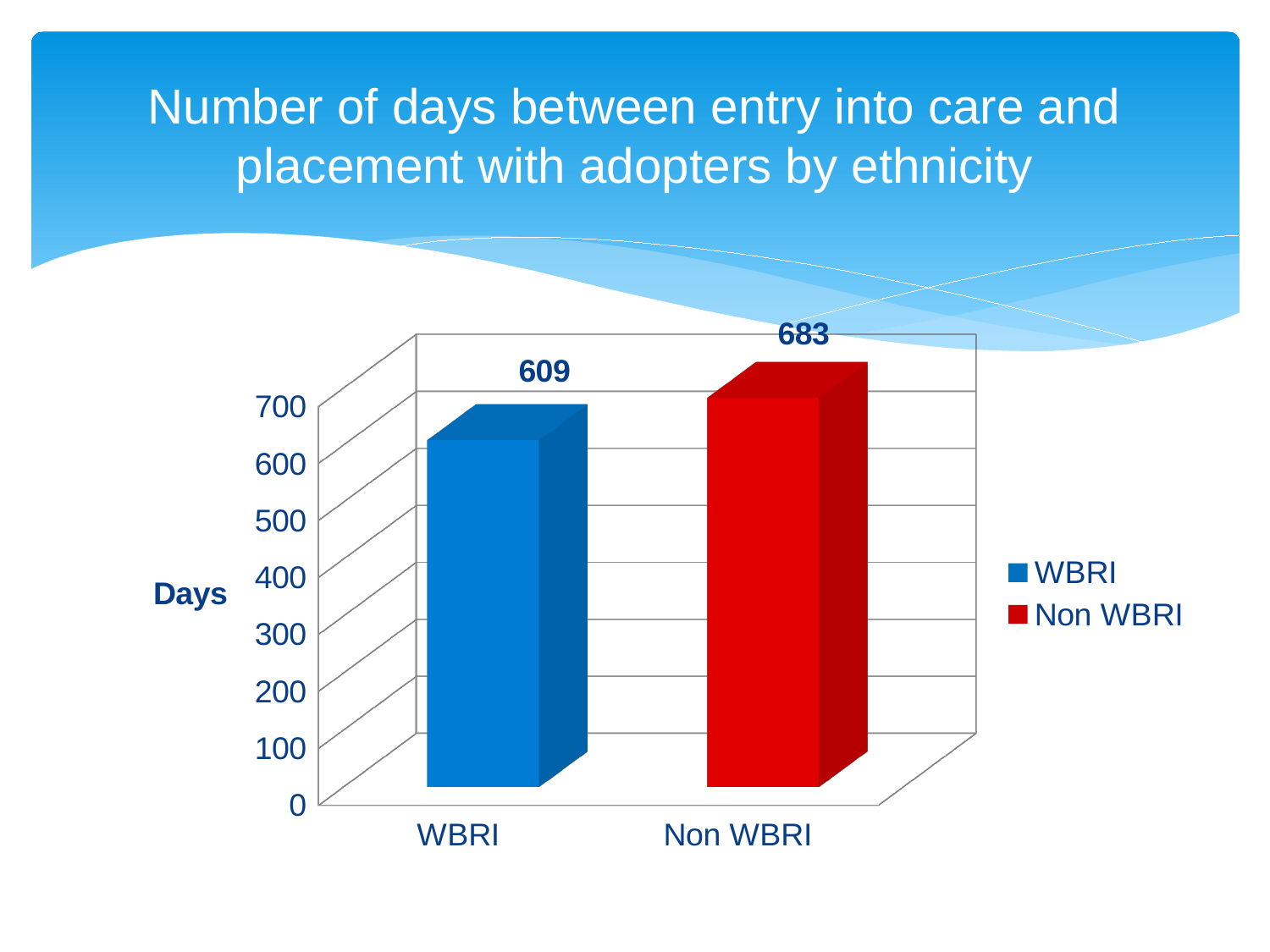
What is the difference in days between Non WBRI and WBRI? 74 What is the label on the vertical axis? Days How many categories are shown on the x axis? 2 Is the value for WBRI greater or less than 500? greater Is the value for Non WBRI greater or less than 700? less How many entries does the legend list? 2 Which category has the higher number of days? Non WBRI What colour is the Non WBRI bar? Red What is the number of days for WBRI? 609 Which category has the lower number of days? WBRI What is the number of days for Non WBRI? 683 What kind of chart is shown on the slide? Bar chart